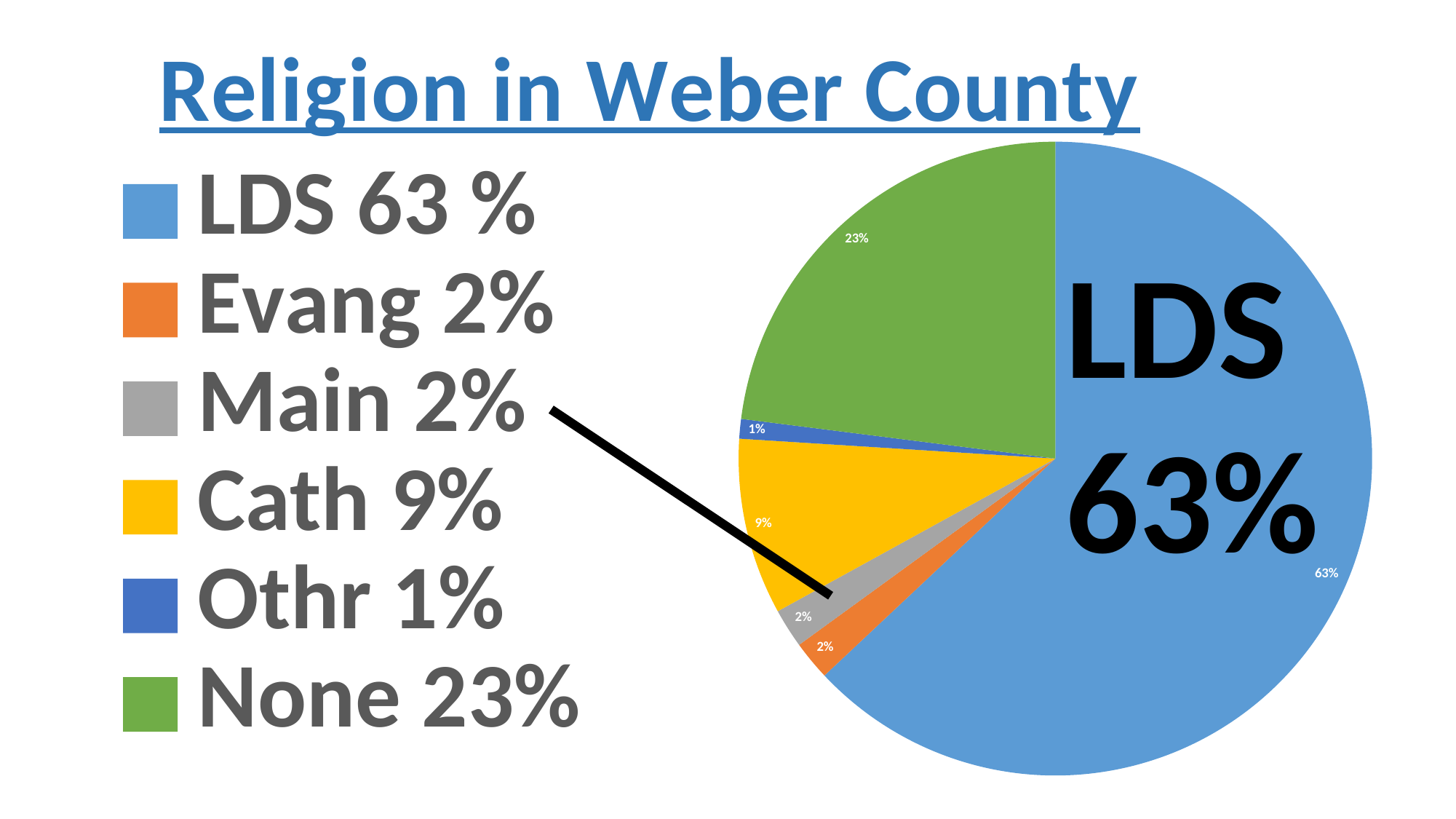
What is the value for Evang? 2% How many categories are shown in the pie chart? 6 What is the value for Othr? 1% What is the title of the slide? Religion in Weber County What is the difference between the LDS share and the None share? 40% Which is larger, the Cath slice or the None slice? None What share of the pie does None represent? 23% What share of the pie does LDS represent? 63% Which category has the smallest slice of the pie? Othr Which category has the largest slice of the pie? LDS What kind of chart is shown on the slide? pie chart What is the value for Cath? 9%